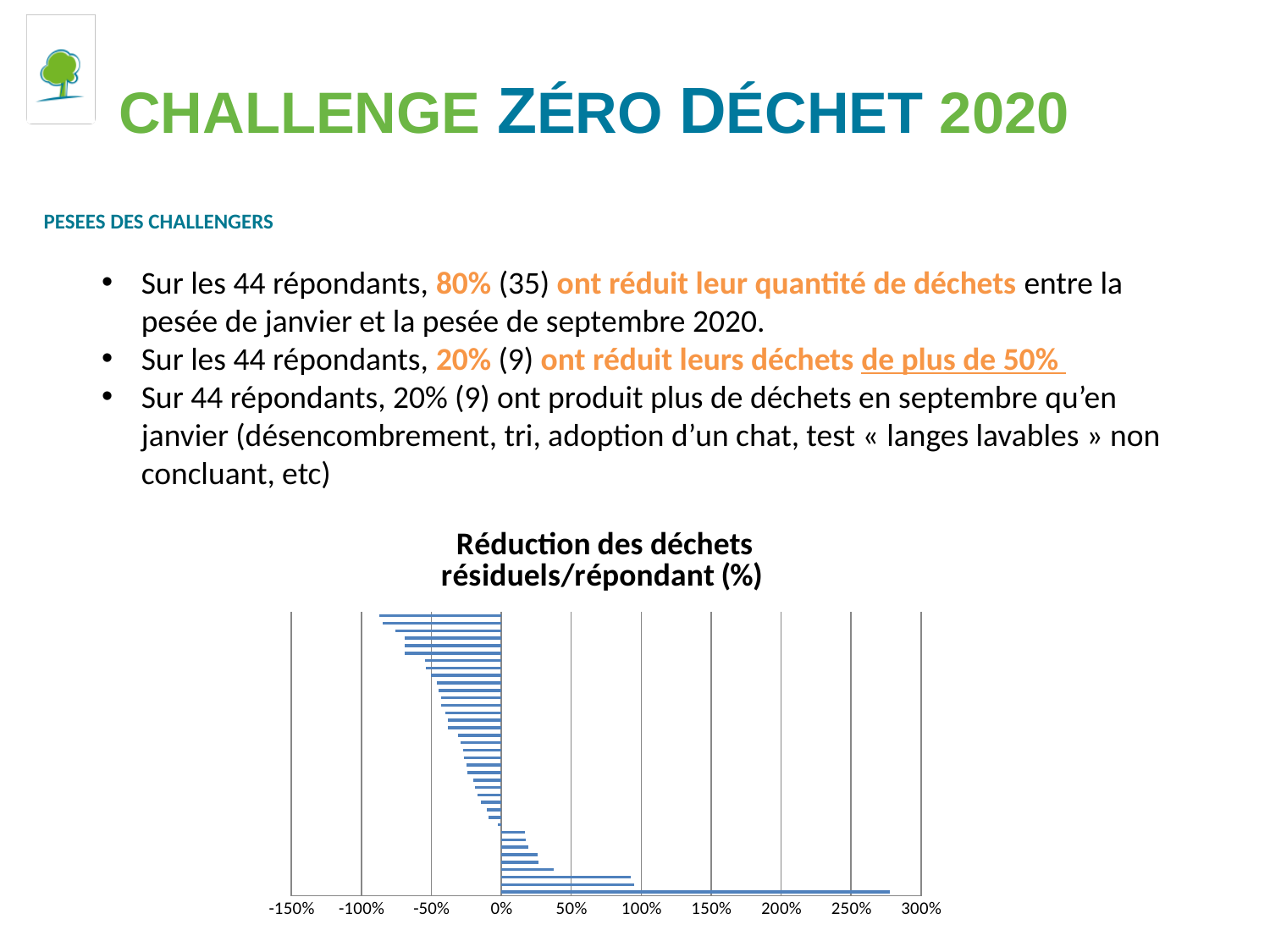
What is the highest value shown on the horizontal axis? 300% Which bar has the larger value, the top bar or the bottom bar? the bottom bar What is the interval between consecutive tick marks on the horizontal axis? 50% What is the title of the chart? Réduction des déchets résiduels/répondant (%) Do the bar values increase or decrease going from the top bar to the bottom bar? increase Are most of the bars in the chart negative or positive? negative How many bars extend beyond 200%? 1 Is the value of the most negative bar (the top bar) greater or less than -50%? less Is the value of the bottom bar greater or less than 150%? greater What kind of chart is shown on the slide? bar chart Is the value of the longest positive bar greater or less than 250%? greater